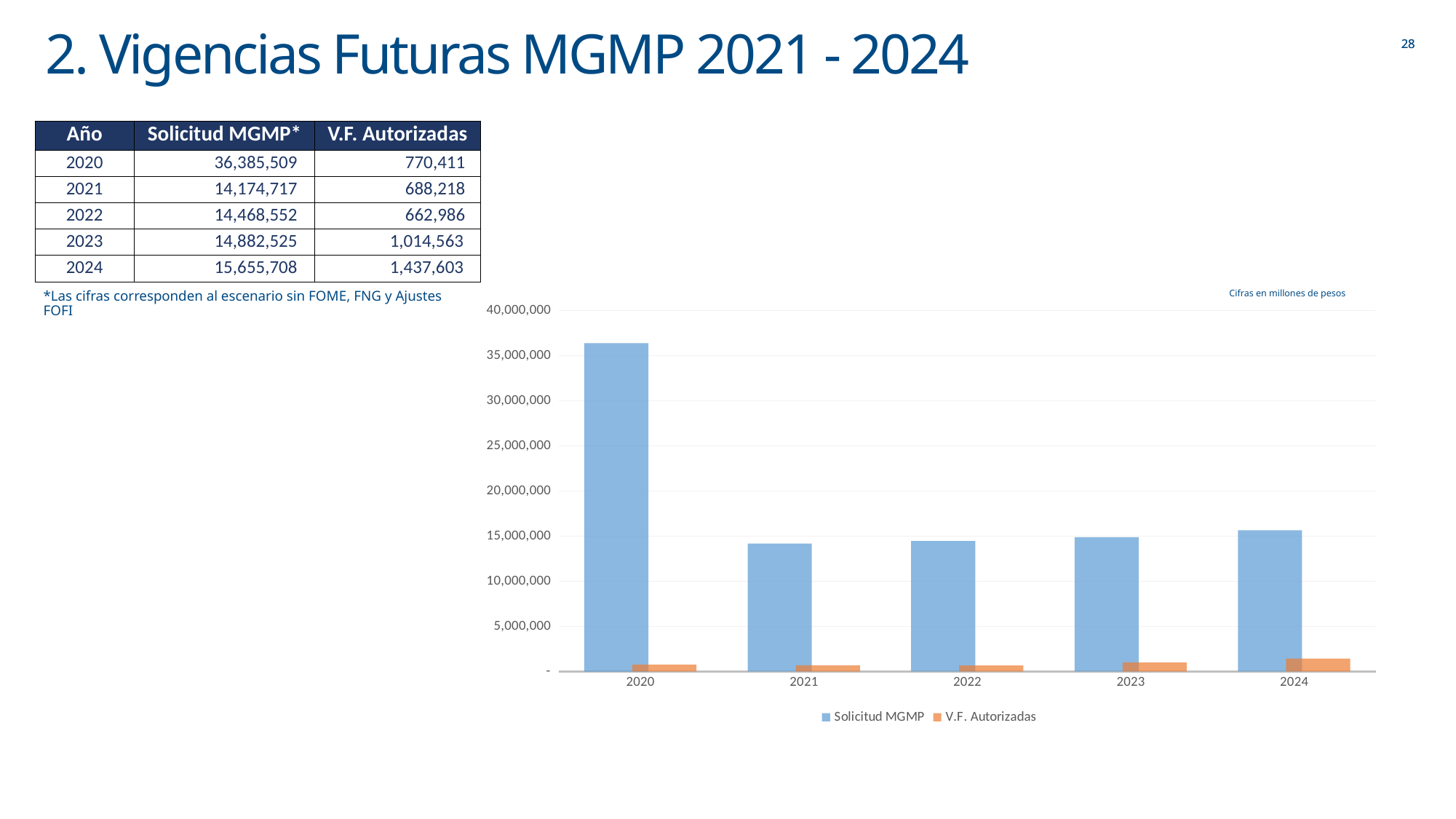
Is the V.F. Autorizadas value for 2024 greater or less than 5,000,000? less Which year has the highest Solicitud MGMP value? 2020 Is the Solicitud MGMP value for 2020 greater or less than 35,000,000? greater Which year has the lowest Solicitud MGMP value? 2021 How many years are shown on the x axis of the chart? 5 Is the Solicitud MGMP value for 2021 greater or less than 15,000,000? less According to the table, what is the V.F. Autorizadas value for 2023? 1,014,563 According to the table, what is the Solicitud MGMP value for 2024? 15,655,708 How many series does the chart legend list? 2 Do the Solicitud MGMP values rise or fall from 2021 to 2024? rise What kind of chart is shown on the slide? bar chart Which is larger in 2023, Solicitud MGMP or V.F. Autorizadas? Solicitud MGMP